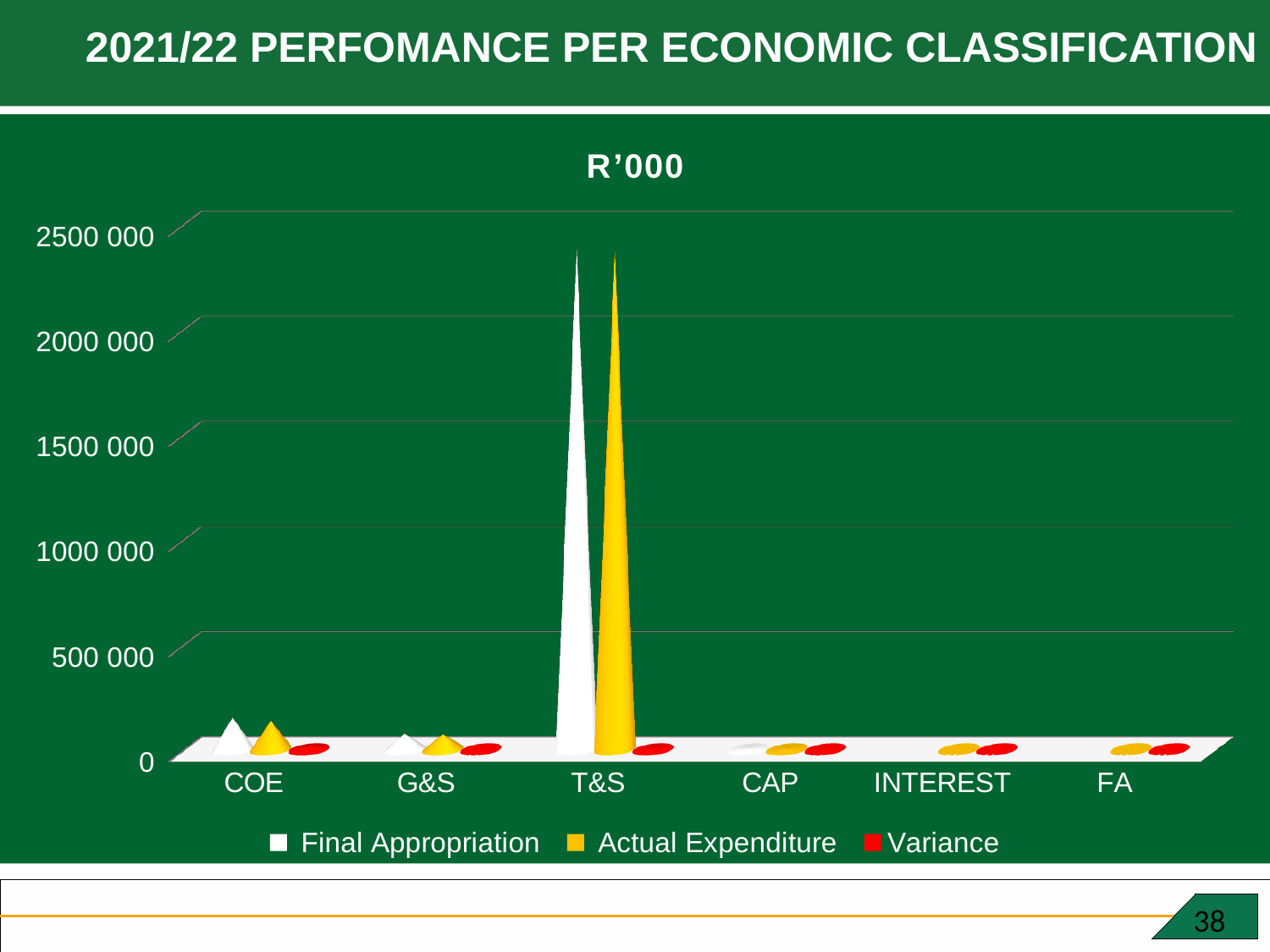
Is the Actual Expenditure for G&S greater or less than 500 000? less Is the Final Appropriation for COE greater or less than 500 000? less What is the title shown above the chart? R’000 Which category has the highest Final Appropriation? T&S How many series does the legend list? 3 Which category has the highest Actual Expenditure? T&S Is the Actual Expenditure for T&S greater or less than 2000 000? greater How many economic classification categories are shown on the x axis? 6 Which is larger, the Final Appropriation for T&S or the Final Appropriation for COE? T&S Which colour represents the Variance series in the legend? red What kind of chart is shown on the slide? bar chart